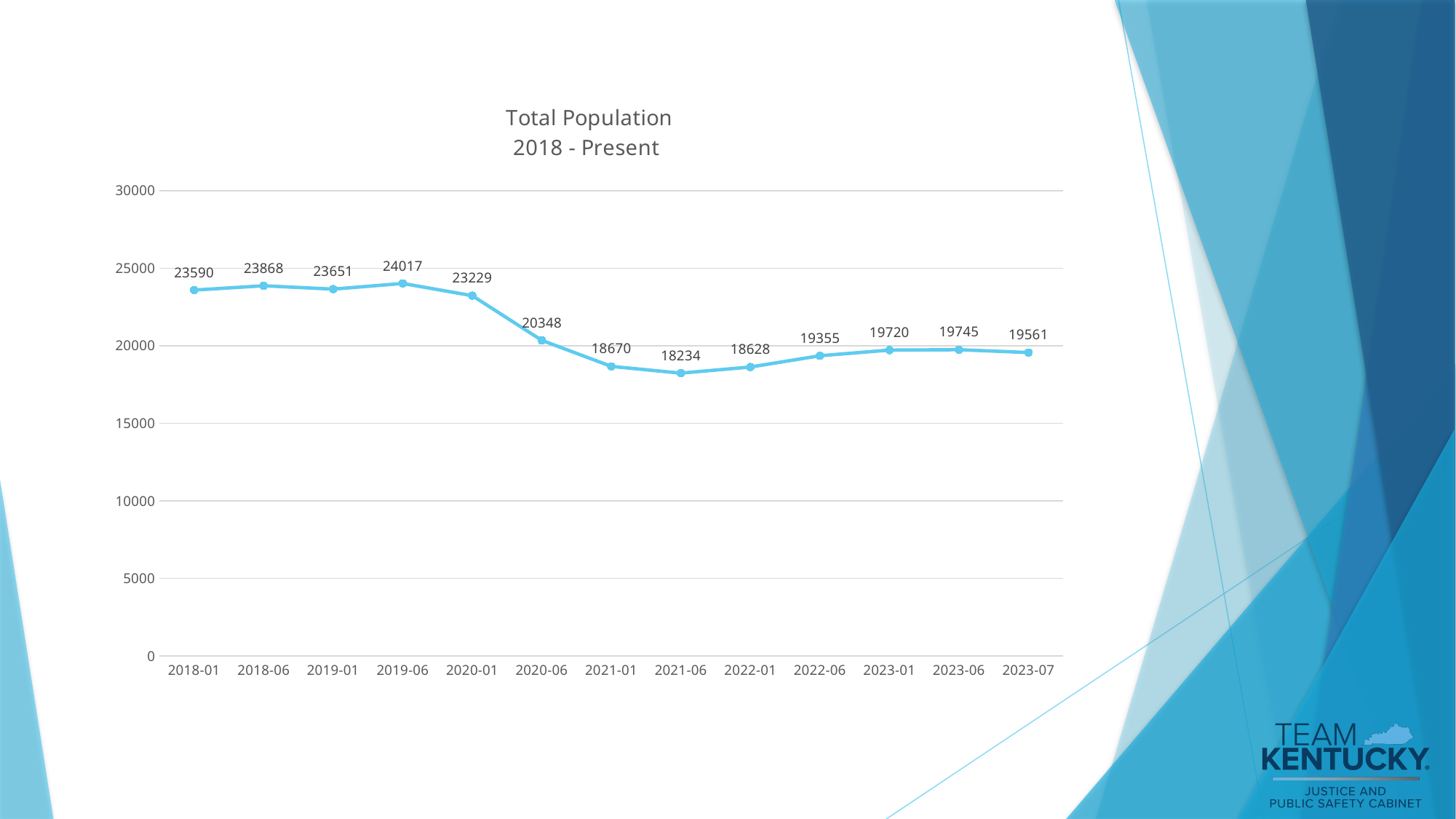
What is the total population value for 2023-07? 19561 What kind of chart is shown on the slide? Line chart What is the difference between the total population in 2018-01 and 2023-07? 4029 What is the total population value for 2019-06? 24017 What is the difference between the total population in 2020-01 and 2020-06? 2881 What is the total population value for 2021-06? 18234 Which date has the highest total population? 2019-06 Is the total population for 2020-06 greater or less than 20000? greater What is the title of the chart? Total Population 2018 - Present Which date has the lowest total population? 2021-06 How many data points are plotted on the chart? 13 Which is larger, the total population in 2022-06 or in 2023-01? 2023-01